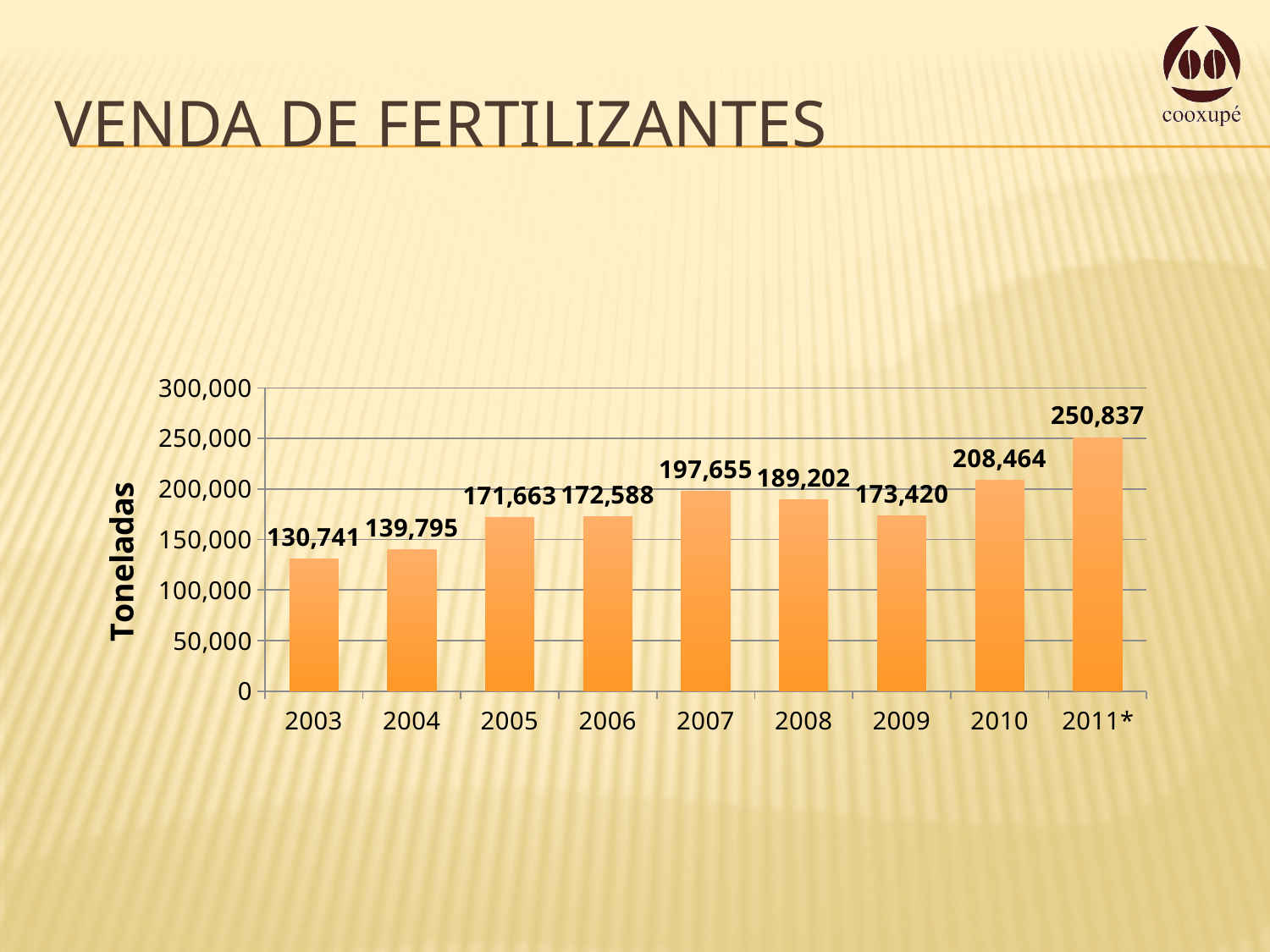
What is the value for 2007? 197,655 What is the difference between the values for 2007 and 2008? 8,453 How many years are shown on the x axis? 9 Which is larger, the value for 2008 or the value for 2009? 2008 What is the difference between the values for 2011* and 2010? 42,373 Is the value for 2010 greater or less than 200,000? greater What is the label of the vertical axis? Toneladas Which year has the highest value? 2011* Which year has the lowest value? 2003 What is the value for 2003? 130,741 What is the value for 2011*? 250,837 What kind of chart is shown on the slide? bar chart